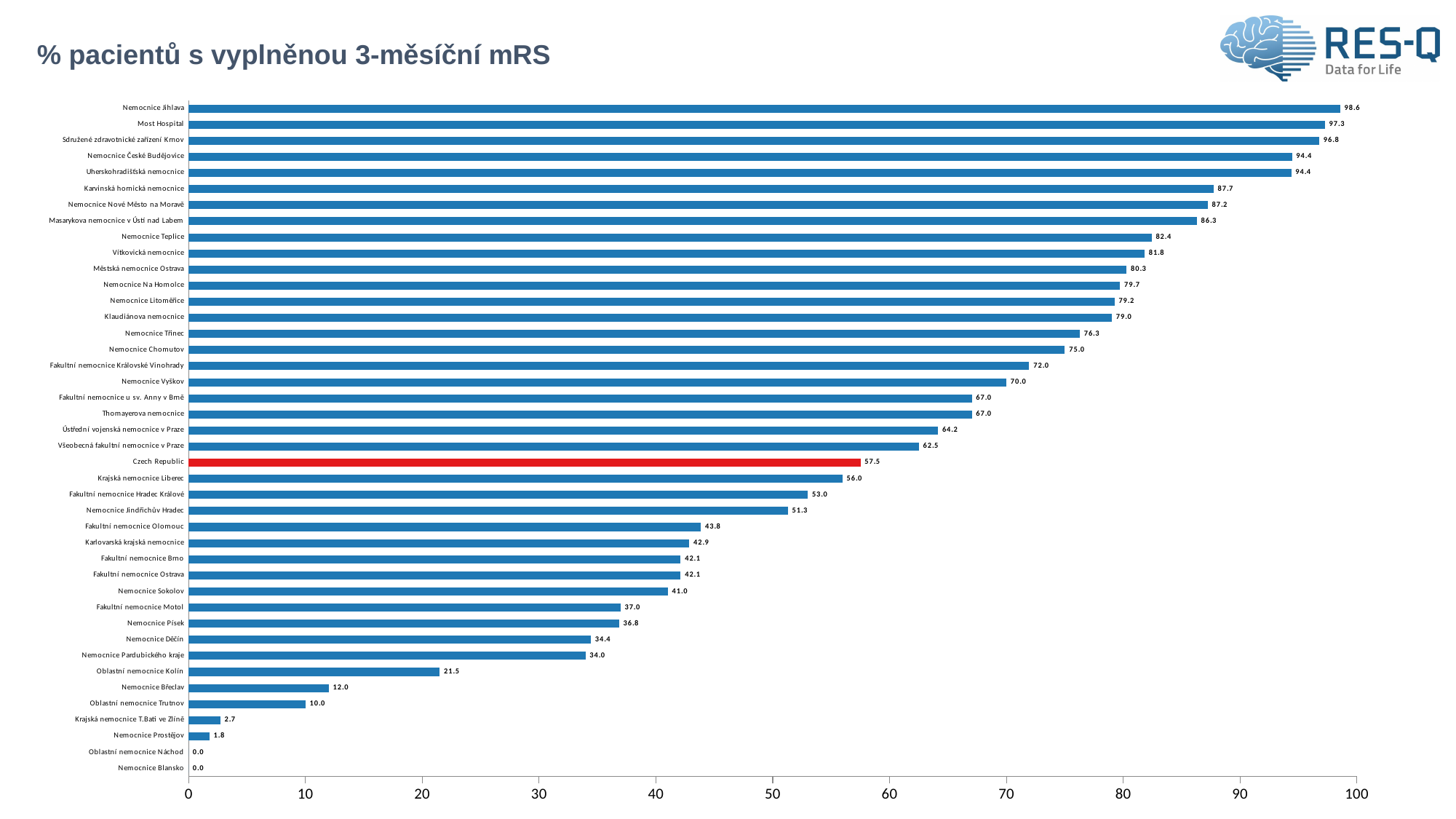
What is the value for Fakultní nemocnice Motol? 37.0 What is the value for Czech Republic? 57.5 What is the title of the chart? % pacientů s vyplněnou 3-měsíční mRS Is the value for Nemocnice Sokolov greater or less than 50? less What is the difference between the values for Most Hospital and Czech Republic? 39.8 Which is larger, the value for Nemocnice Teplice or the value for Nemocnice Chomutov? Nemocnice Teplice What is the value for Nemocnice Prostějov? 1.8 What is the value for Oblastní nemocnice Kolín? 21.5 What kind of chart is shown on the slide? bar chart Which bar is coloured red instead of blue? Czech Republic Which category has the highest value? Nemocnice Jihlava What is the value for Nemocnice Jihlava? 98.6